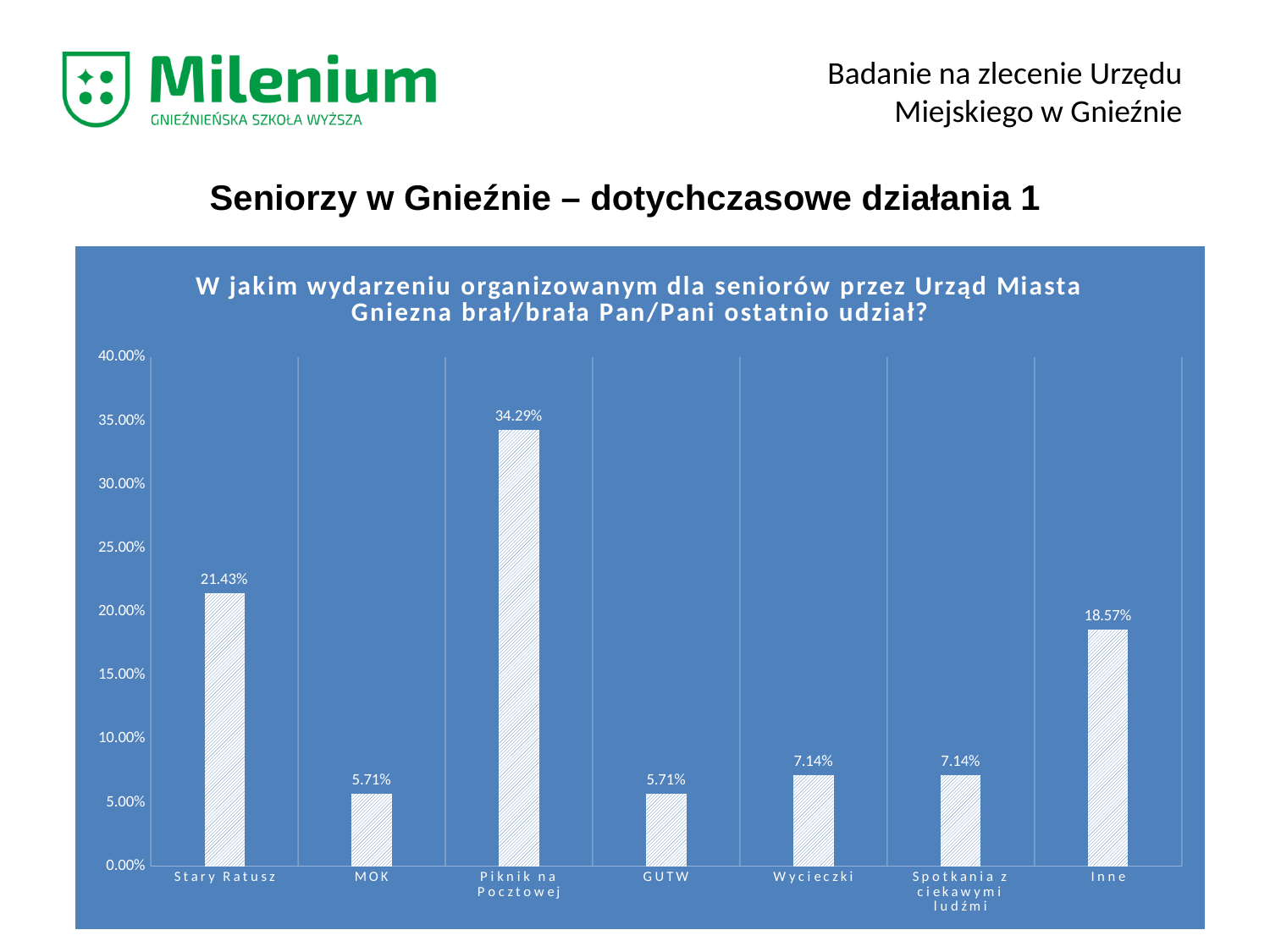
Which category has the highest value? Piknik na Pocztowej What is the value for Wycieczki? 7.14% What is the value for Stary Ratusz? 21.43% What is the difference between the values for Piknik na Pocztowej and Stary Ratusz? 12.86% What is the value for Piknik na Pocztowej? 34.29% What is the title of the chart? W jakim wydarzeniu organizowanym dla seniorów przez Urząd Miasta Gniezna brał/brała Pan/Pani ostatnio udział? What is the difference between the values for Stary Ratusz and Inne? 2.86% Which is larger, the value for Stary Ratusz or the value for Inne? Stary Ratusz Is the value for Piknik na Pocztowej greater or less than 30.00%? greater What kind of chart is shown on the slide? bar chart What is the value for Inne? 18.57% How many categories are shown on the x axis? 7